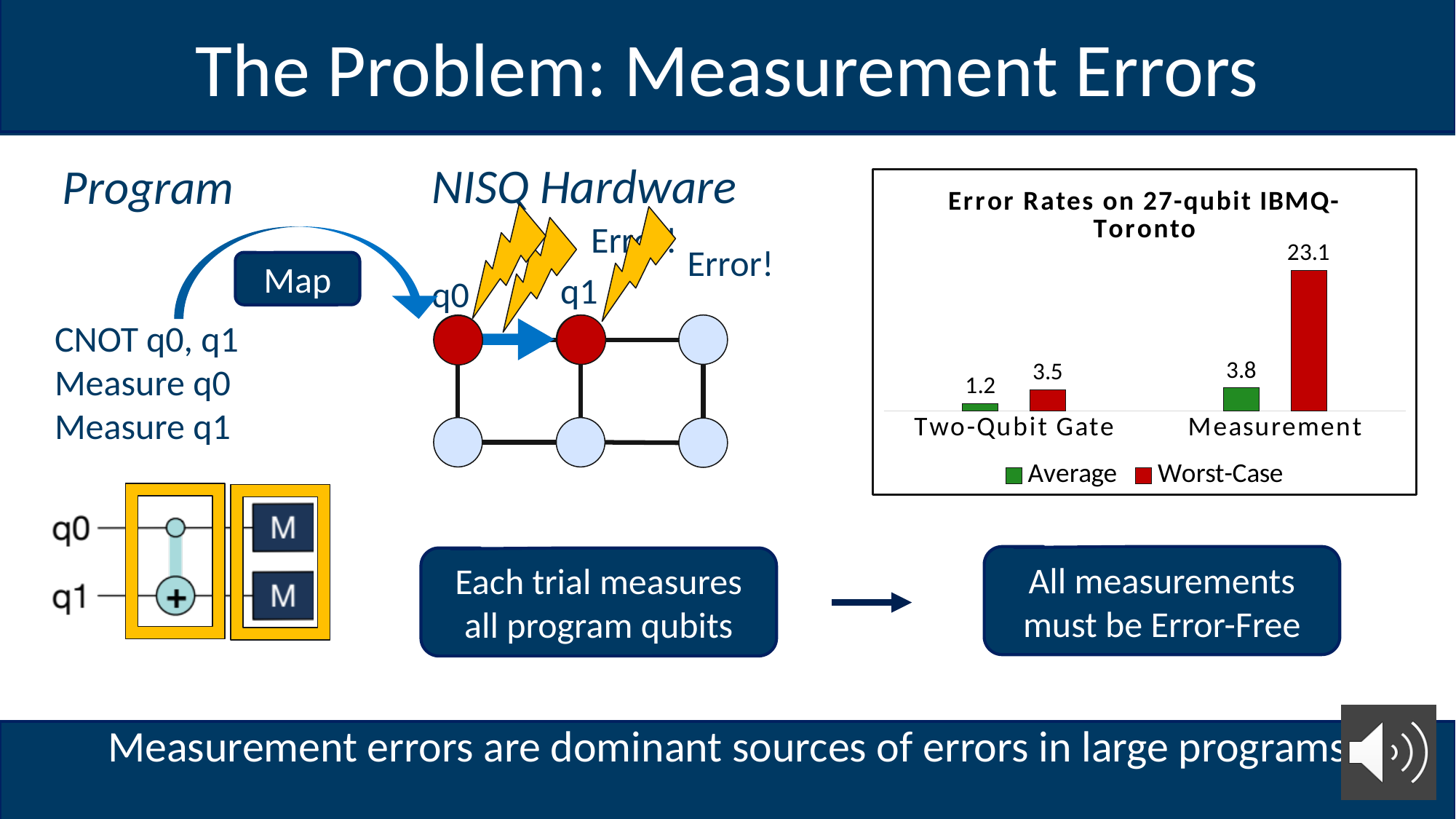
What kind of chart is shown on the slide? Bar chart How many series does the legend list? 2 What is the difference between the Worst-Case and Average error rates for Measurement? 19.3 What is the difference between the Worst-Case error rates for Measurement and Two-Qubit Gate? 19.6 What is the Worst-Case error rate for Measurement? 23.1 Which category has the lowest Average error rate? Two-Qubit Gate Which is larger: the Average error rate for Measurement or the Worst-Case error rate for Two-Qubit Gate? Average error rate for Measurement Which category has the highest Worst-Case error rate? Measurement What is the title of the chart? Error Rates on 27-qubit IBMQ-Toronto What is the Average error rate for Two-Qubit Gate? 1.2 What is the Average error rate for Measurement? 3.8 What is the Worst-Case error rate for Two-Qubit Gate? 3.5